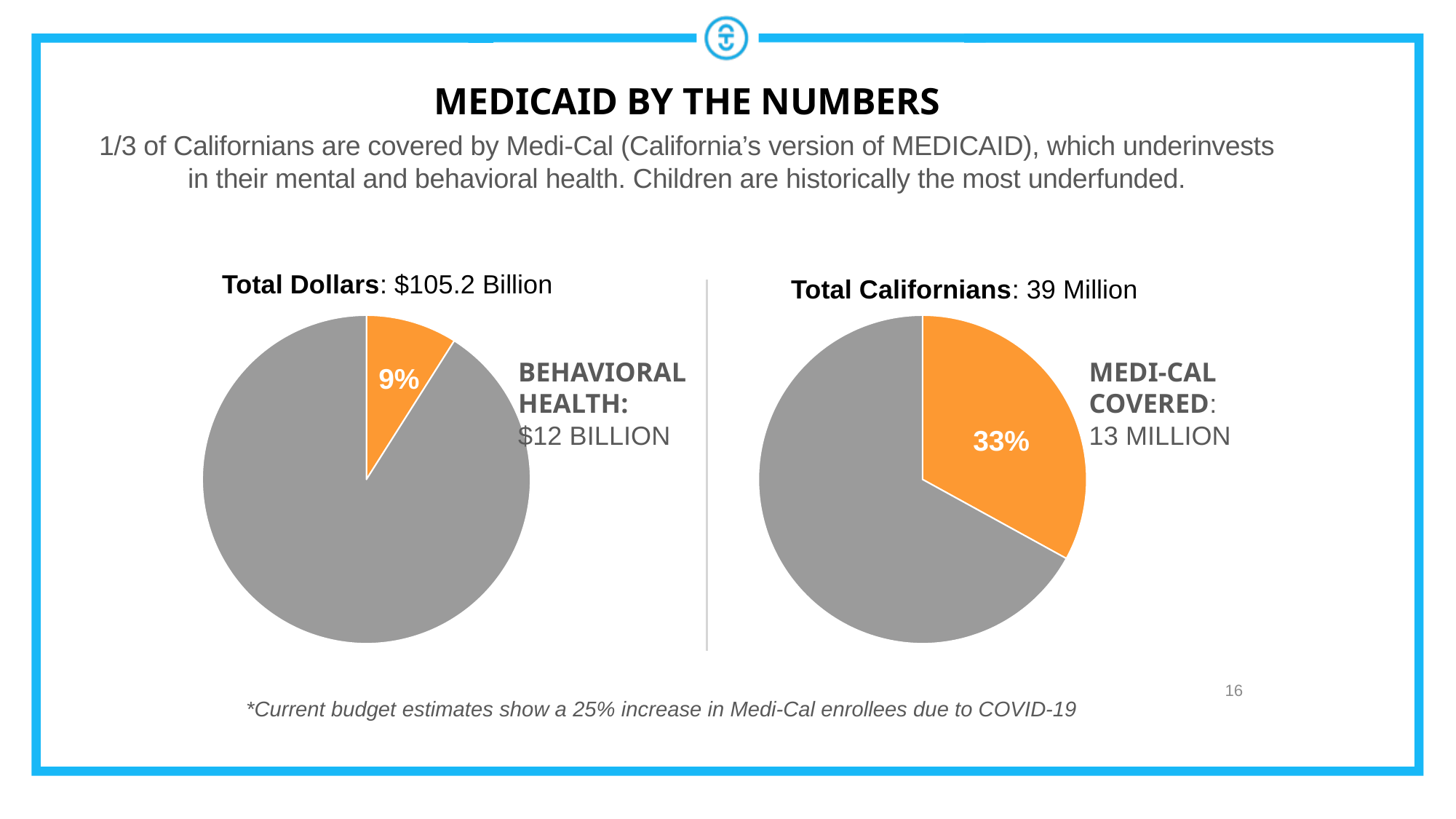
Which slice is larger in the Total Dollars pie chart, the orange Behavioral Health slice or the grey slice? the grey slice What is the difference in percentage points between the orange slice of the Total Californians chart and the orange slice of the Total Dollars chart? 24 percentage points What colour is the Medi-Cal Covered slice in the Total Californians pie chart? orange In the Total Californians pie chart, what share of the pie does the Medi-Cal Covered slice represent? 33% Which pie chart has the larger orange slice, Total Dollars or Total Californians? Total Californians In the Total Dollars chart, what dollar amount is labeled for Behavioral Health? $12 BILLION What kind of chart is the Total Dollars chart on the left? pie chart In the Total Dollars pie chart, what share of the pie does the Behavioral Health slice represent? 9% In the Total Californians chart, how many people are labeled as Medi-Cal Covered? 13 MILLION What total is shown in the title of the right pie chart? 39 Million How many slices does the Total Californians pie chart have? 2 What total is shown in the title of the left pie chart? $105.2 Billion